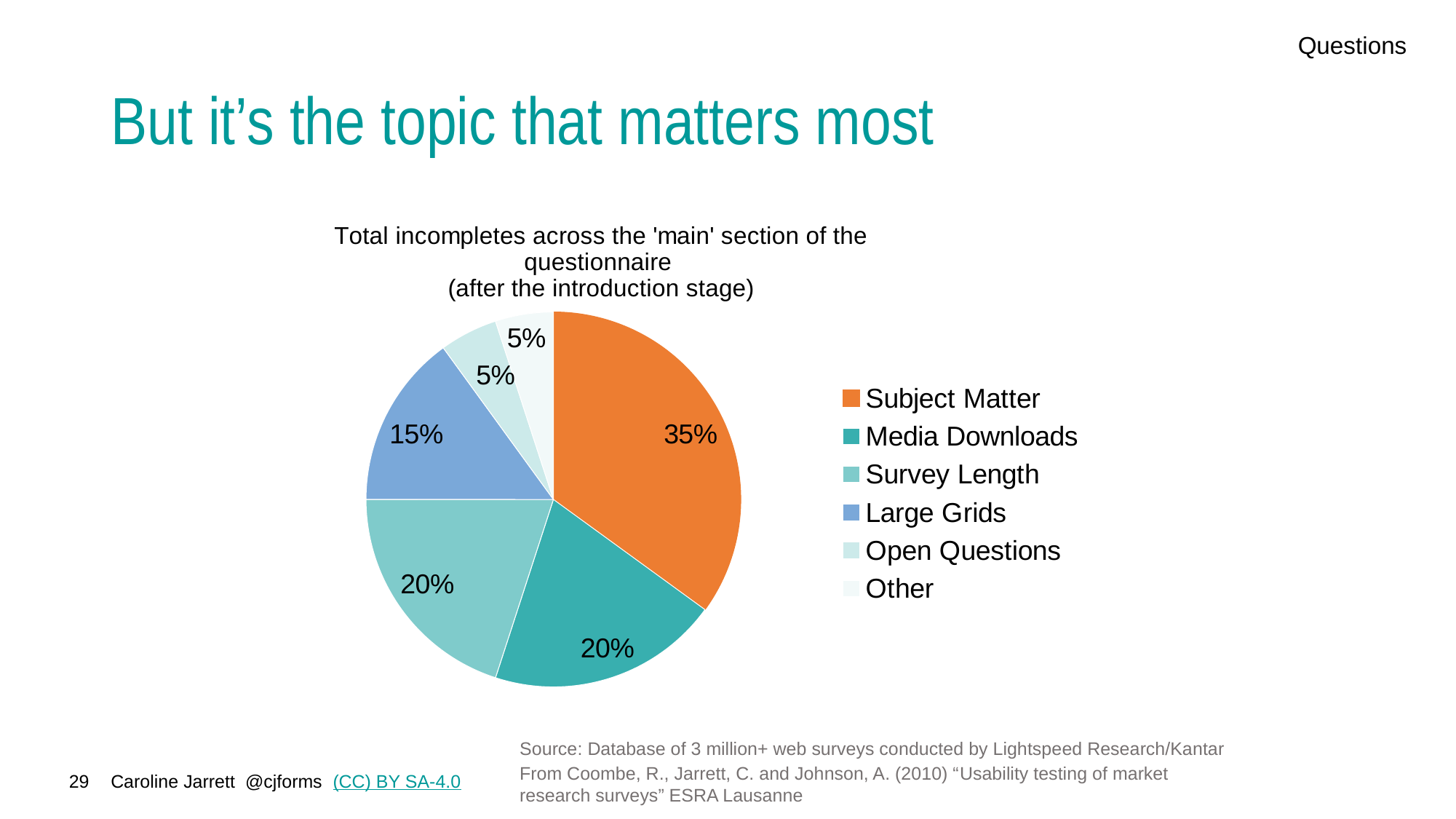
What kind of chart is shown on the slide? Pie chart What is the value shown for Open Questions? 5% Which category is shown in orange in the legend? Subject Matter How many categories does the pie chart show? 6 Which is larger, the share for Survey Length or the share for Large Grids? Survey Length Which two categories share the smallest slice of the pie? Open Questions and Other What is the value shown for Large Grids? 15% What is the value shown for Media Downloads? 20% What share of the pie does Subject Matter account for? 35% What is the title of the pie chart? Total incompletes across the 'main' section of the questionnaire (after the introduction stage) Which category has the largest slice of the pie? Subject Matter What is the difference between the Subject Matter share and the Large Grids share? 20%